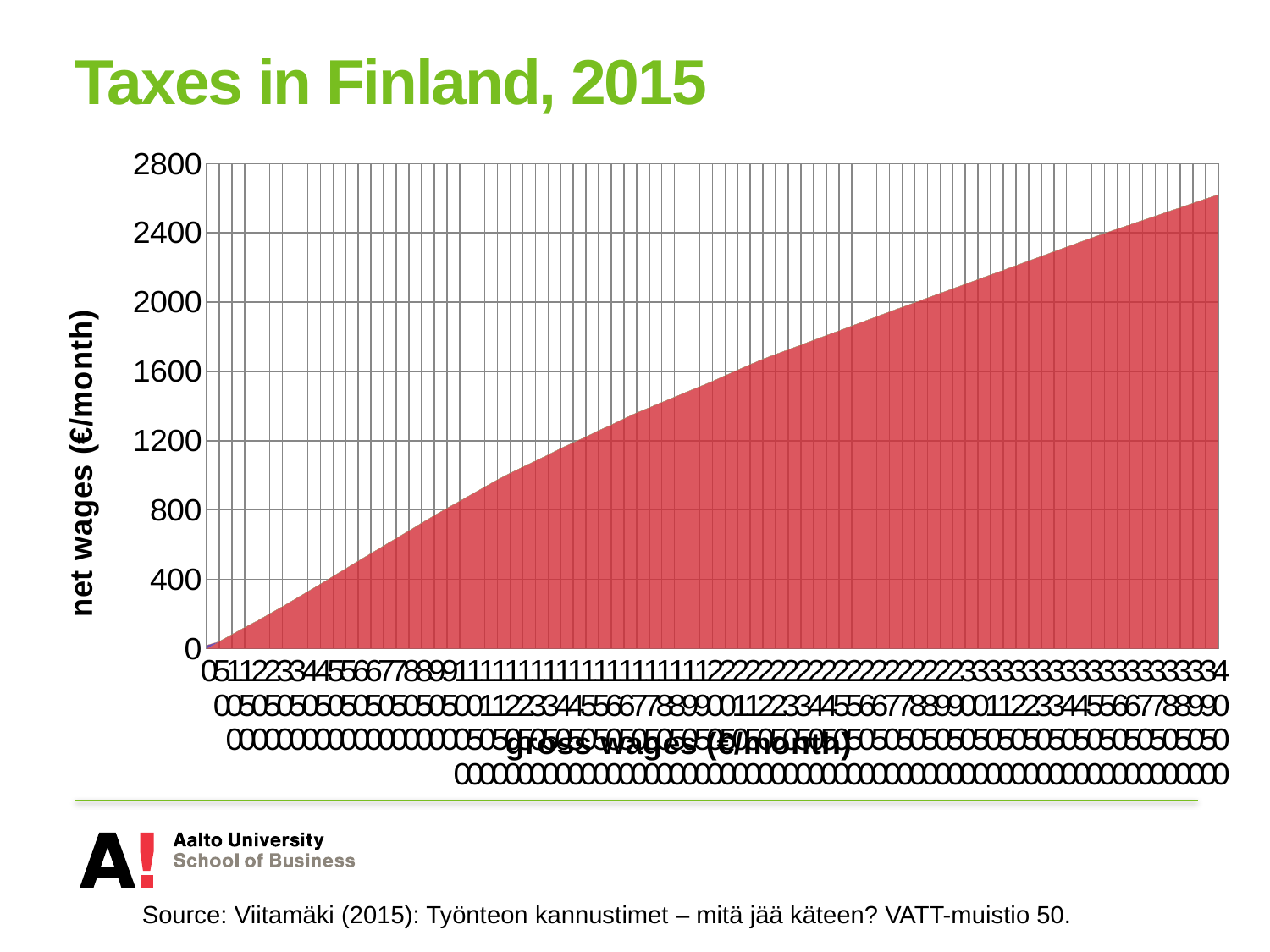
What kind of chart is shown on the slide? area chart What is the label of the vertical axis? net wages (€/month) Is the highest plotted net wage value greater or less than 2800? less Is the highest plotted net wage value greater or less than 2400? greater What is the title of the slide containing the chart? Taxes in Finland, 2015 Do net wages rise or fall as gross wages increase along the x axis? rise